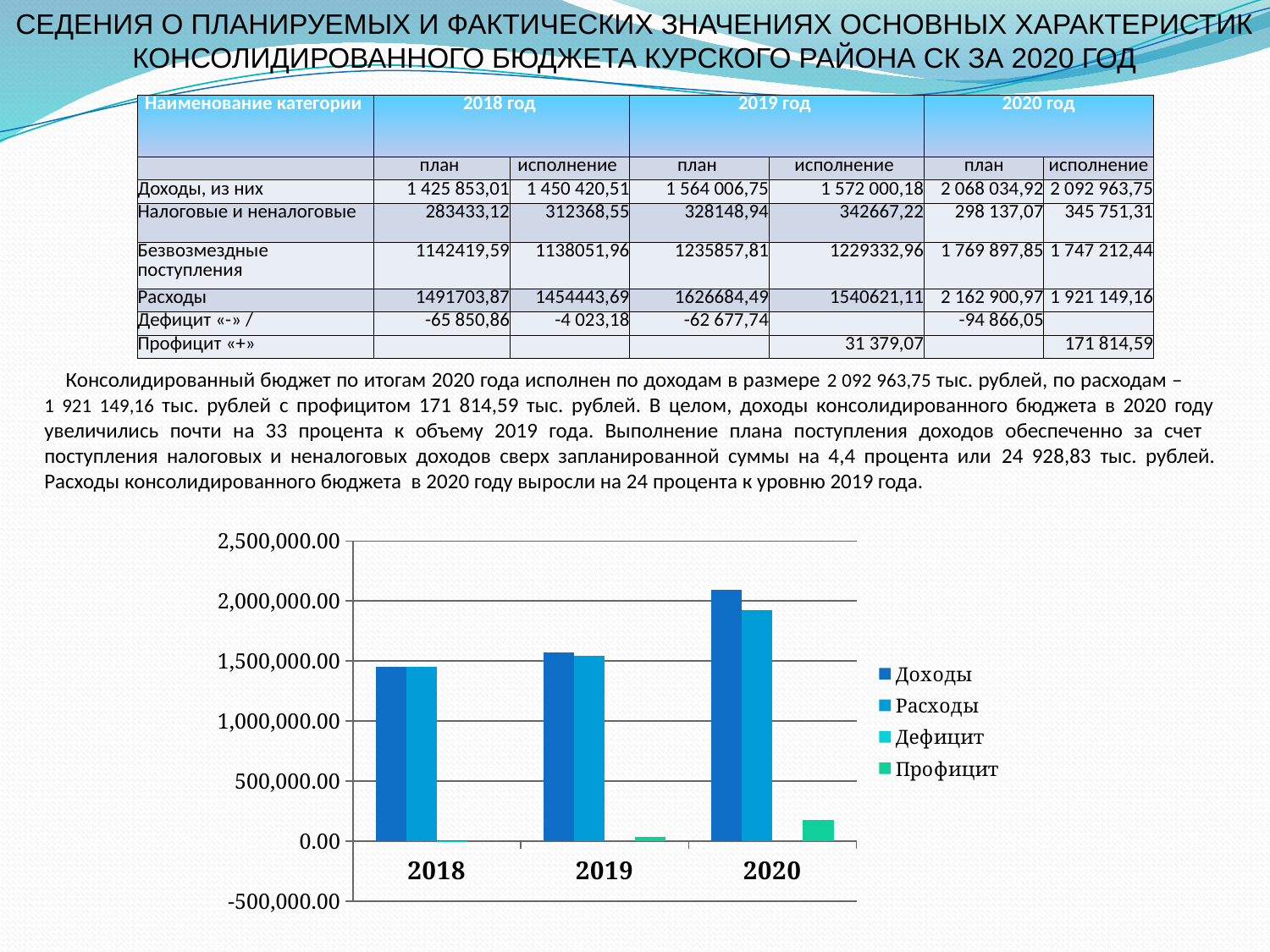
Which year has the lowest Расходы bar in the chart? 2018 What are the four series listed in the chart legend? Доходы, Расходы, Дефицит, Профицит Do the Доходы bars rise or fall from 2018 to 2020? rise Is the Расходы value for 2020 greater or less than 2,000,000.00? less Is the Профицит value for 2020 greater or less than 500,000.00? less Which year has the highest Доходы bar in the chart? 2020 How many series does the chart legend list? 4 In 2020, which is larger in the chart, Доходы or Расходы? Доходы What kind of chart is shown on the slide? bar chart Is the Доходы value for 2018 greater or less than 1,500,000.00? less How many years are shown on the x axis of the chart? 3